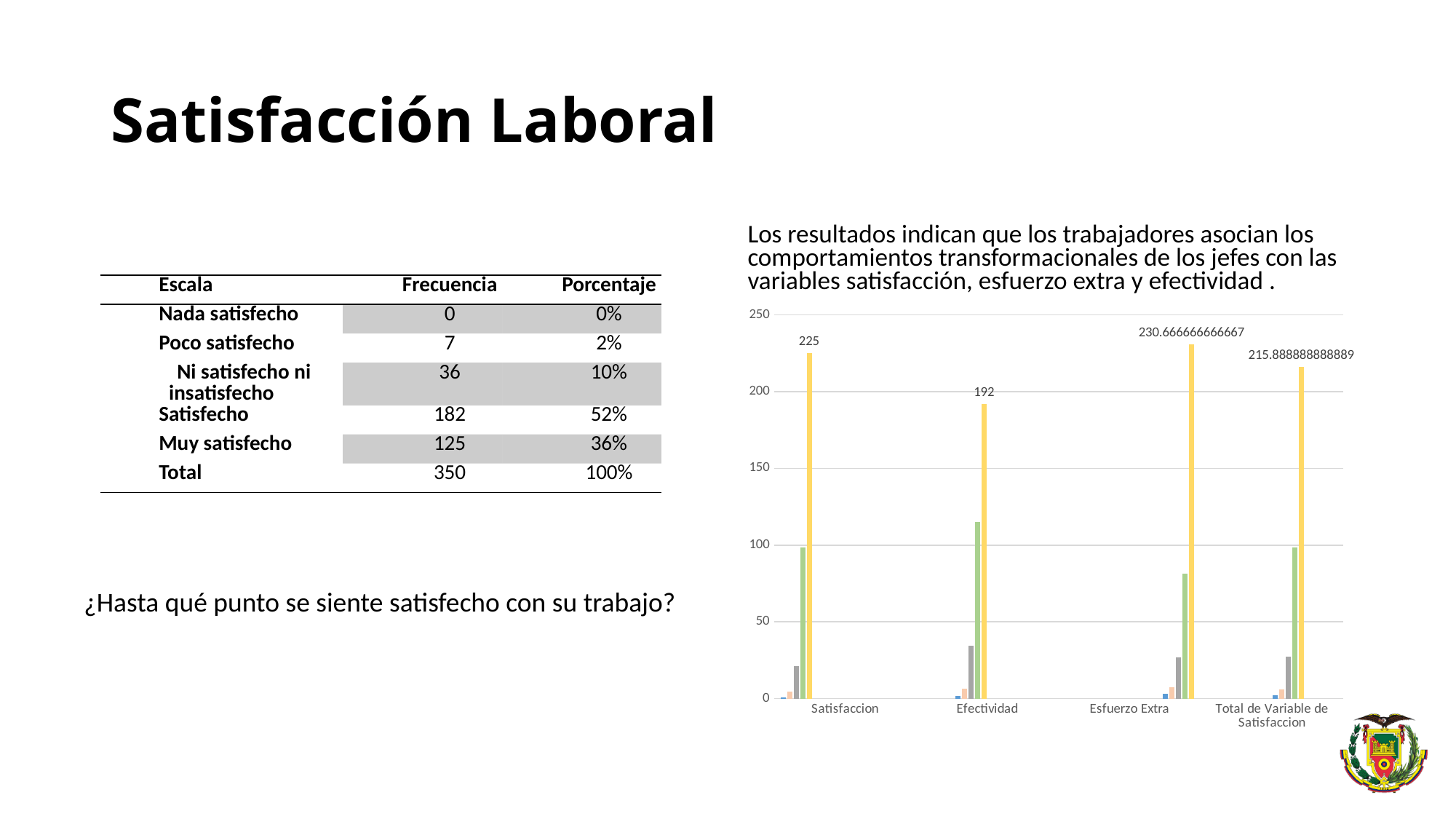
What is the value of the tallest (yellow) bar for Efectividad? 192 What is the value of the tallest (yellow) bar for Total de Variable de Satisfaccion? 215.888888888889 Is the value of the green bar for Esfuerzo Extra greater or less than 100? less Which category has the lowest labelled yellow bar? Efectividad Which is larger, the yellow bar for Satisfaccion or the yellow bar for Total de Variable de Satisfaccion? Satisfaccion What is the value of the tallest (yellow) bar for Esfuerzo Extra? 230.666666666667 Is the value of the green bar for Efectividad greater or less than 100? greater What is the difference between the yellow bar values for Satisfaccion and Efectividad? 33 Which category has the highest labelled yellow bar? Esfuerzo Extra What is the value of the tallest (yellow) bar for Satisfaccion? 225 What kind of chart is shown on the slide? Bar chart How many categories are shown on the x axis of the chart? 4